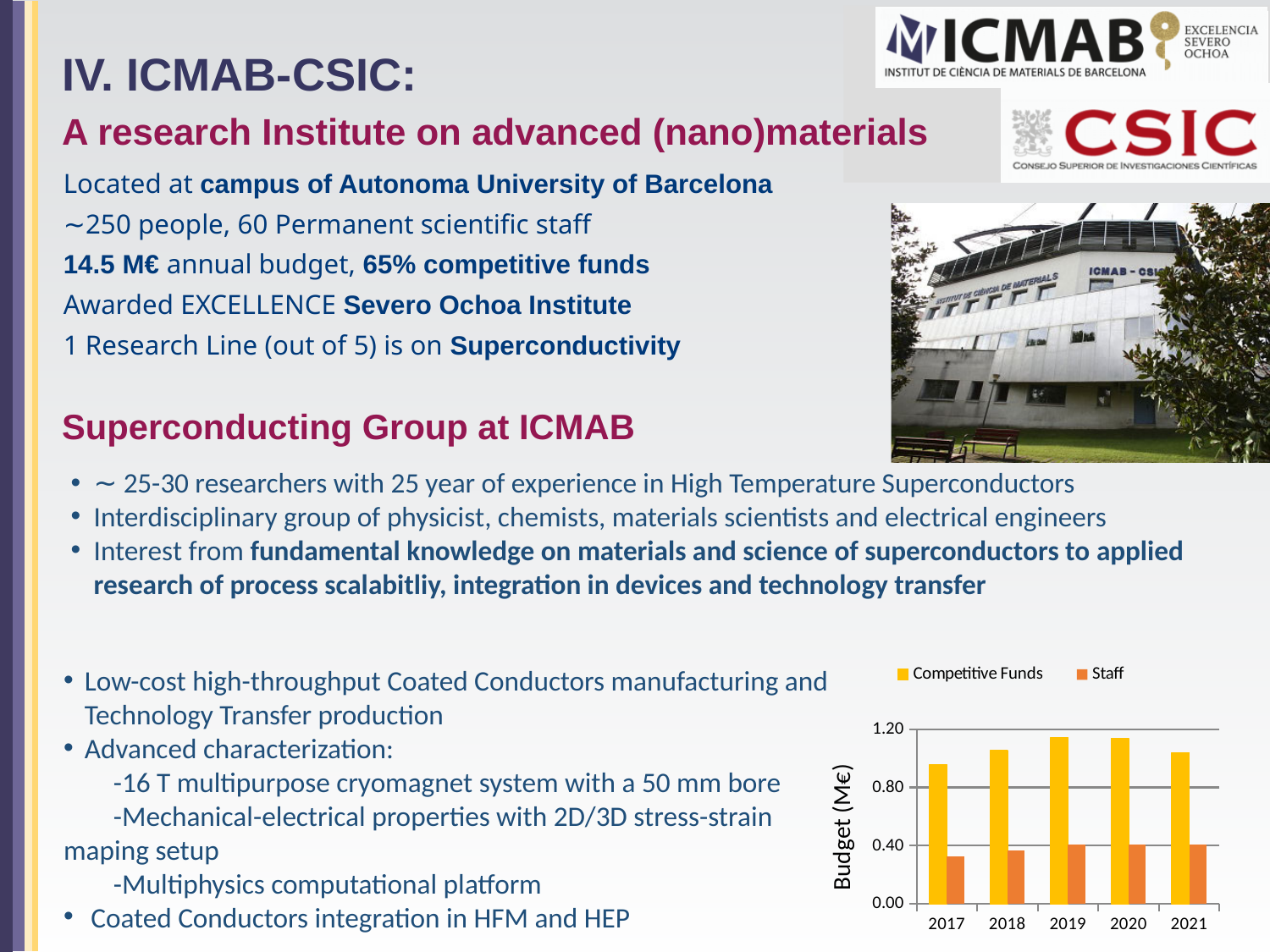
Which two series are listed in the legend of the budget chart? Competitive Funds and Staff Is the Competitive Funds value for 2017 greater or less than 0.80? greater Is the Staff value for 2017 greater or less than 0.40? less Which is larger in 2019, Competitive Funds or Staff? Competitive Funds How many series does the legend of the budget chart list? 2 What kind of chart is shown at the bottom right of the slide? Bar chart Do the Competitive Funds values rise or fall from 2017 to 2019? rise In which year is the Competitive Funds bar lowest? 2017 What is the label of the vertical axis of the budget chart? Budget (M€) Is the Competitive Funds value for 2019 greater or less than 1.20? less In which year is the Staff bar lowest? 2017 How many years are shown on the x axis of the budget chart? 5